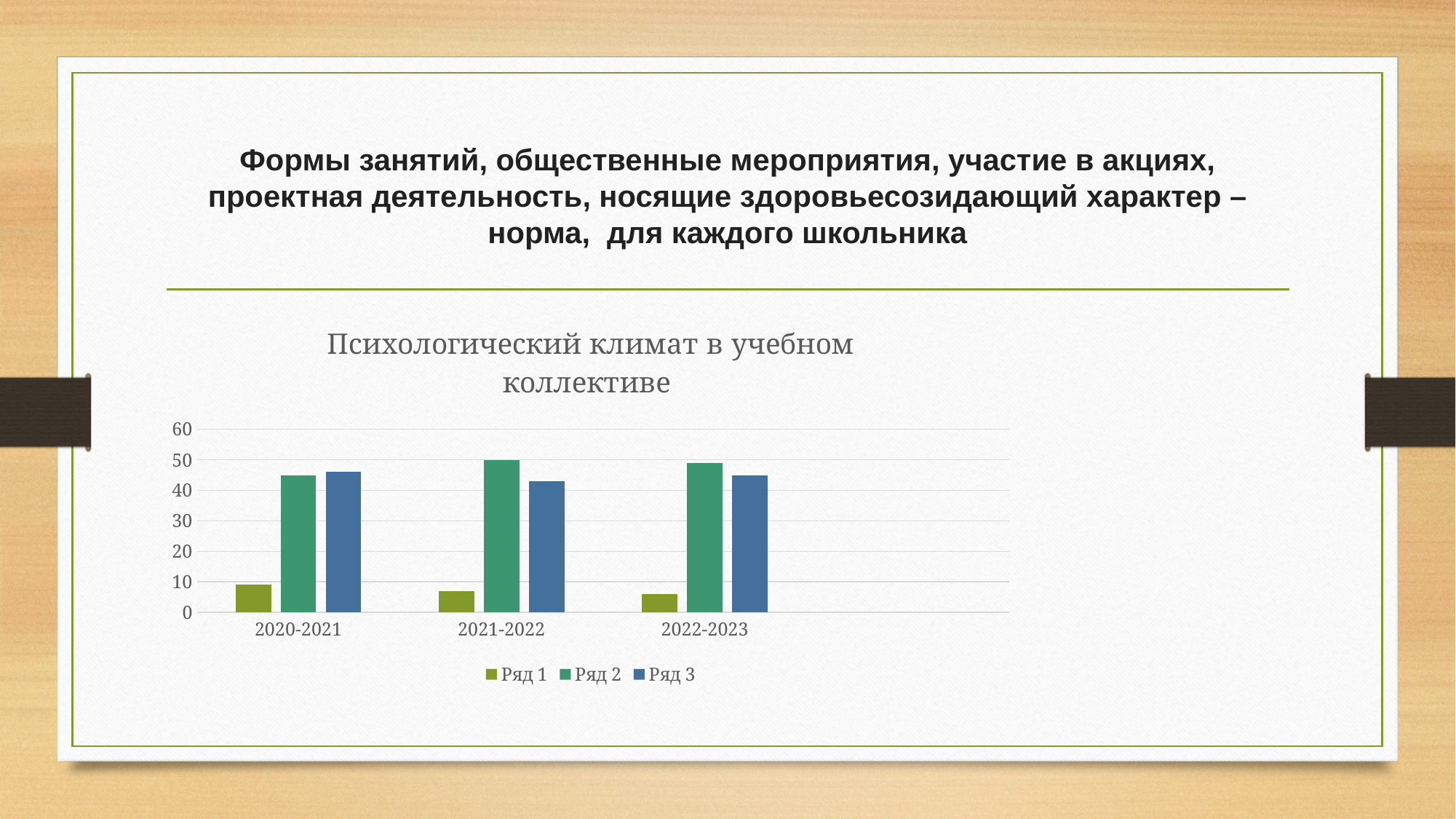
What kind of chart is shown on the slide? bar chart Is the value for Ряд 2 in 2022-2023 greater or less than 40? greater Which categories appear on the x axis? 2020-2021, 2021-2022, 2022-2023 Is the value for Ряд 3 in 2021-2022 greater or less than 50? less Which is larger in 2021-2022, Ряд 2 or Ряд 3? Ряд 2 Is the value for Ряд 2 in 2020-2021 greater or less than 40? greater Do the values for Ряд 1 rise or fall from 2020-2021 to 2022-2023? fall How many series does the legend list? 3 What is the title of the chart? Психологический климат в учебном коллективе Which is larger in 2022-2023, Ряд 1 or Ряд 3? Ряд 3 How many categories are shown on the x axis? 3